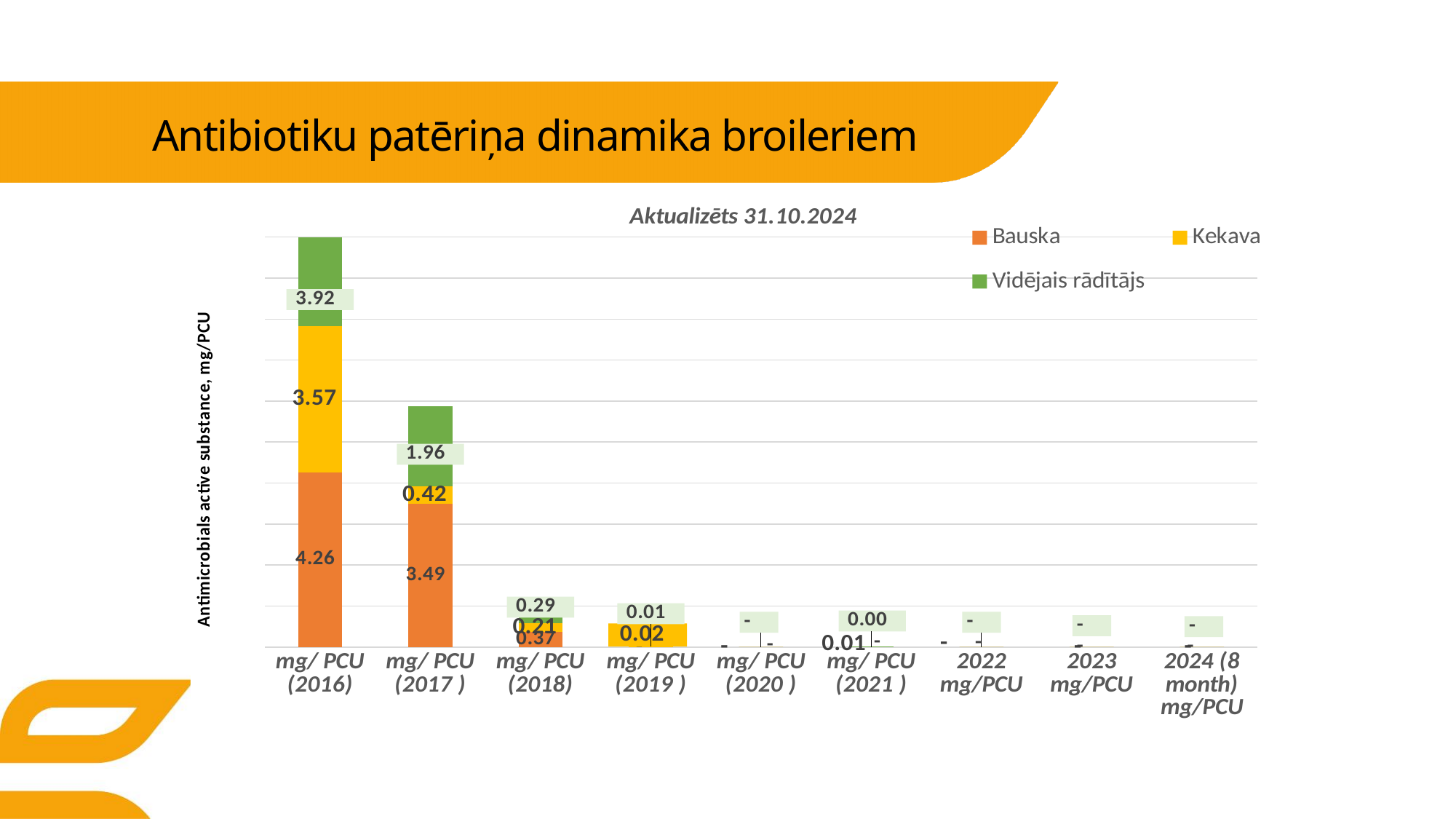
How many series does the legend list? 3 What is the difference between the Kekava values for 2016 and 2017? 3.15 What is the difference between the Bauska values for 2016 and 2017? 0.77 What is the value for Bauska in the mg/ PCU (2016) category? 4.26 In the mg/ PCU (2017 ) category, which is larger, Bauska or Kekava? Bauska What is the value for Kekava in the mg/ PCU (2017 ) category? 0.42 What is the value for Vidējais rādītājs in the mg/ PCU (2018) category? 0.29 In which category is the Bauska value highest? mg/ PCU (2016) Do the Bauska values rise or fall from 2016 to 2018? fall What kind of chart is shown on the slide? stacked bar chart What is the value for Kekava in the mg/ PCU (2019 ) category? 0.02 How many categories are shown on the x axis? 9